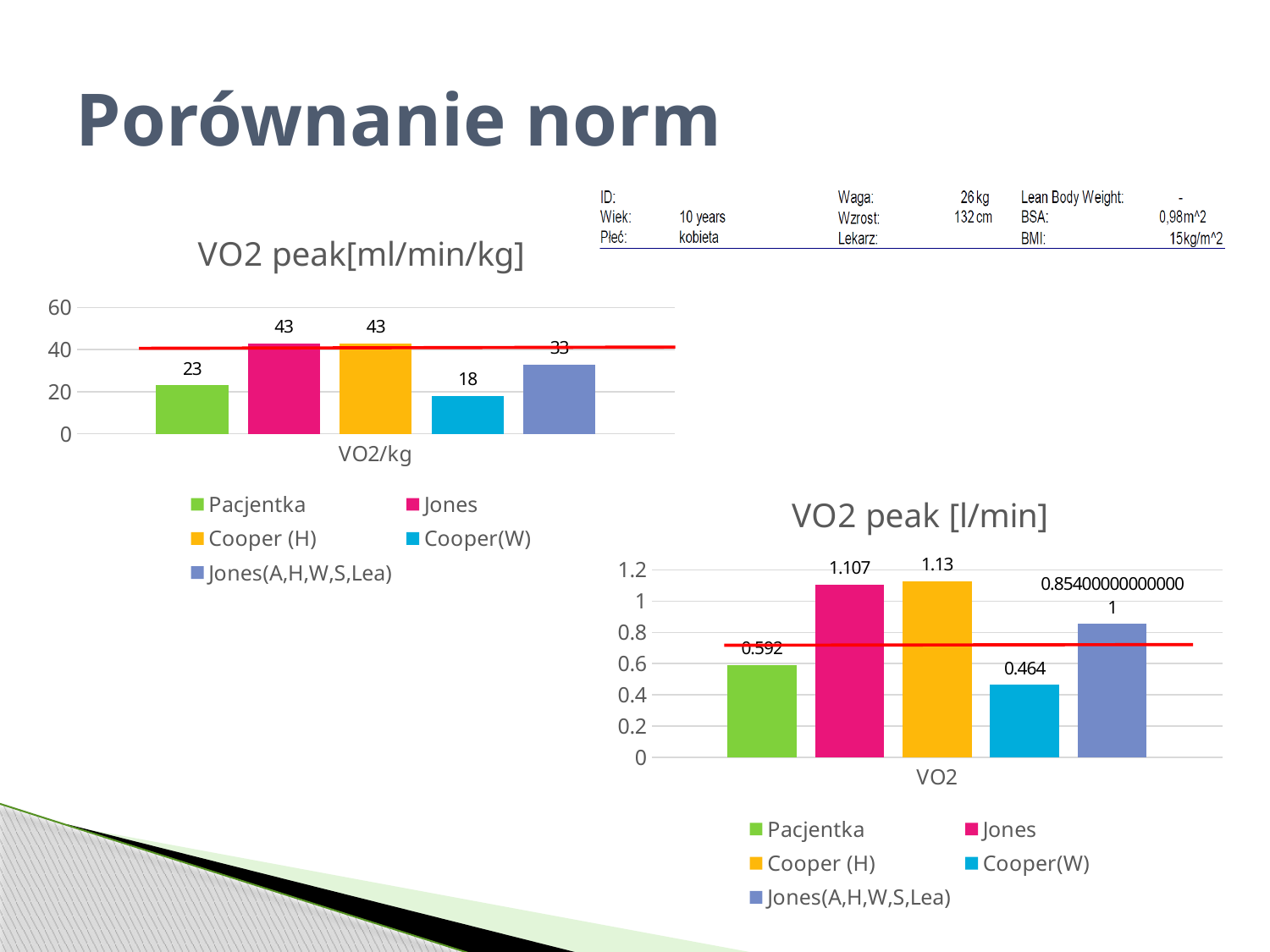
In the 'VO2 peak [l/min]' chart, is the value for Jones(A,H,W,S,Lea) greater or less than 0.8? greater In the 'VO2 peak[ml/min/kg]' chart, is the value for Jones(A,H,W,S,Lea) greater or less than 40? less In the 'VO2 peak[ml/min/kg]' chart, what is the value for Pacjentka? 23 In the 'VO2 peak [l/min]' chart, which is larger: the value for Jones or the value for Pacjentka? Jones What kind of chart is the 'VO2 peak [l/min]' chart? bar chart In the 'VO2 peak[ml/min/kg]' chart, what is the value for Cooper(W)? 18 In the 'VO2 peak [l/min]' chart, which series has the lowest value? Cooper(W) In the 'VO2 peak[ml/min/kg]' chart, which series has the lowest value? Cooper(W) In the 'VO2 peak[ml/min/kg]' chart, what is the difference between the Jones value and the Pacjentka value? 20 In the 'VO2 peak [l/min]' chart, what is the value for Pacjentka? 0.592 How many series does the legend of the 'VO2 peak[ml/min/kg]' chart list? 5 In the 'VO2 peak [l/min]' chart, what is the value for Cooper (H)? 1.13